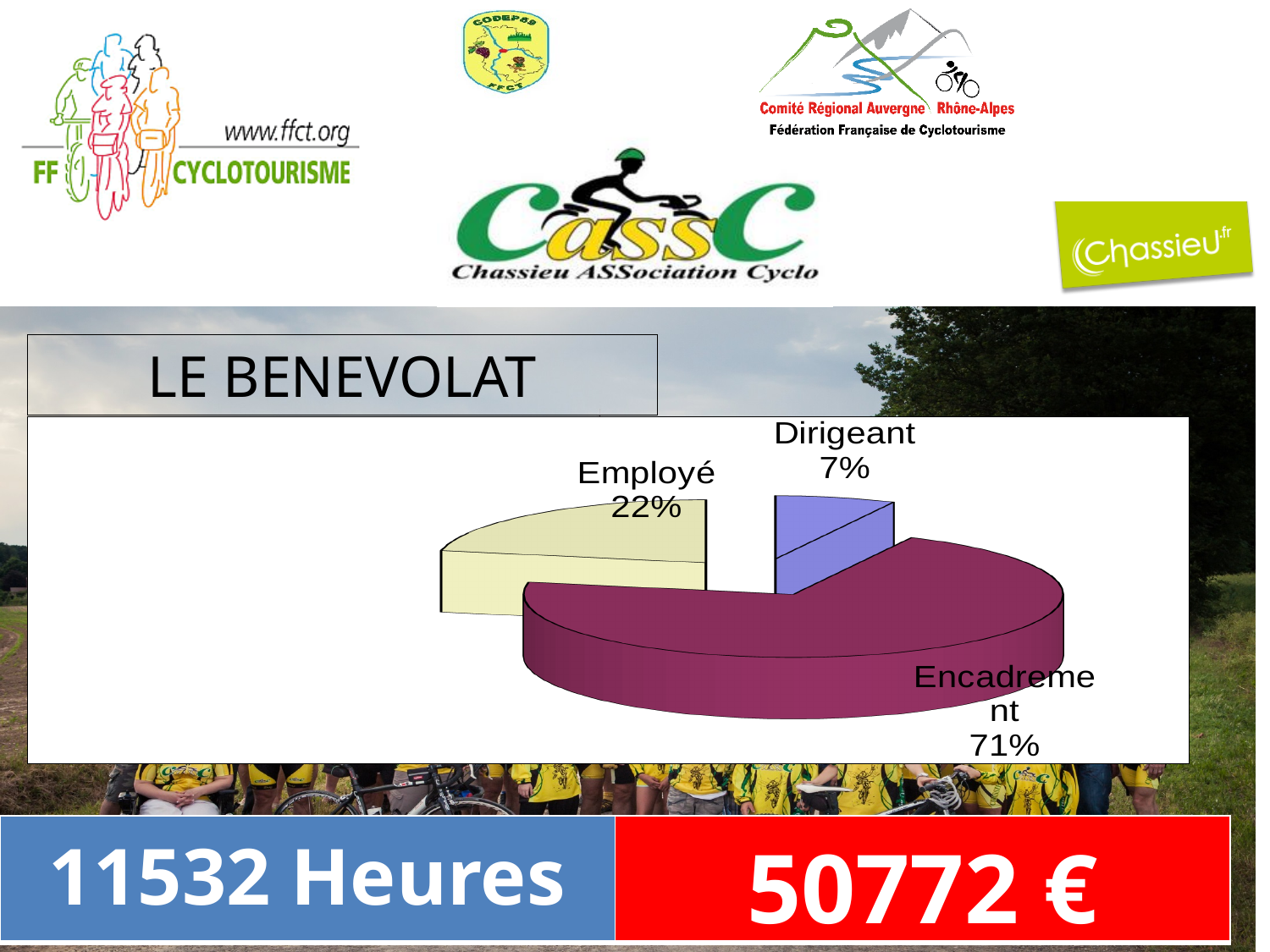
Is the share for Encadrement greater or less than 50%? greater How many slices does the pie chart have? 3 Which is larger, the share for Employé or the share for Dirigeant? Employé Which category has the largest slice of the pie? Encadrement What is the difference in percentage points between Encadrement and Employé? 49 What is the title shown above the pie chart? LE BENEVOLAT What is the difference in percentage points between Employé and Dirigeant? 15 What share of the pie does Encadrement represent? 71% Which category has the smallest slice of the pie? Dirigeant What kind of chart is shown on the slide? pie chart What share of the pie does Dirigeant represent? 7% What share of the pie does Employé represent? 22%